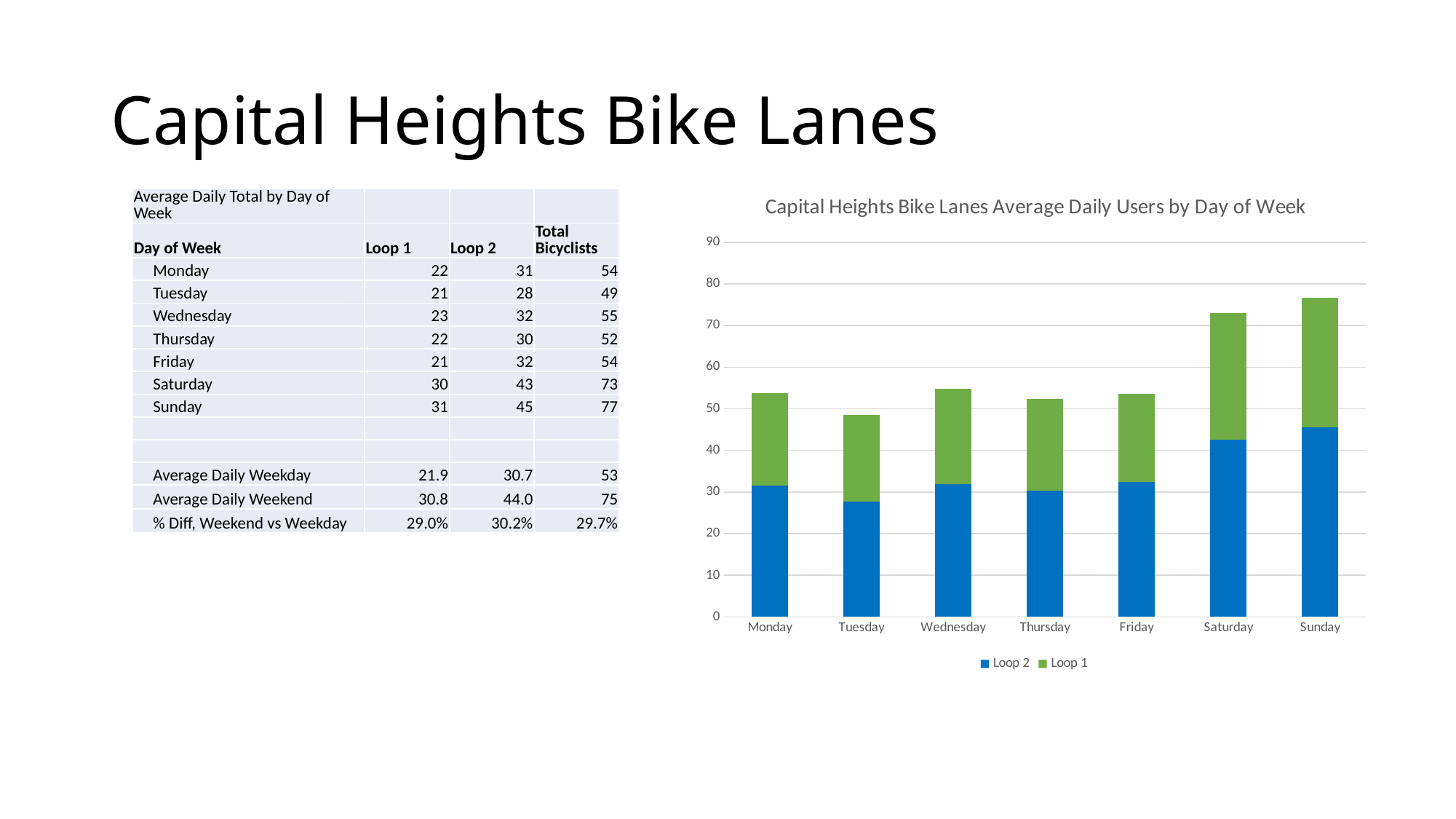
Which day has the highest total stacked bar in the chart? Sunday According to the table, what is the difference in Total Bicyclists between Sunday and Tuesday? 28 Is the total stacked bar for Saturday greater or less than 70? greater What colour represents Loop 2 in the chart? blue Is the total stacked bar for Tuesday greater or less than 50? less Which day has the lowest total stacked bar in the chart? Tuesday Do the total stacked bars rise or fall from Friday to Sunday? rise According to the table, what is the Loop 2 value for Sunday? 45 How many days of the week are plotted on the x axis of the chart? 7 What kind of chart is shown on the slide? bar chart Which has a taller total stacked bar, Saturday or Wednesday? Saturday How many series does the chart legend list? 2